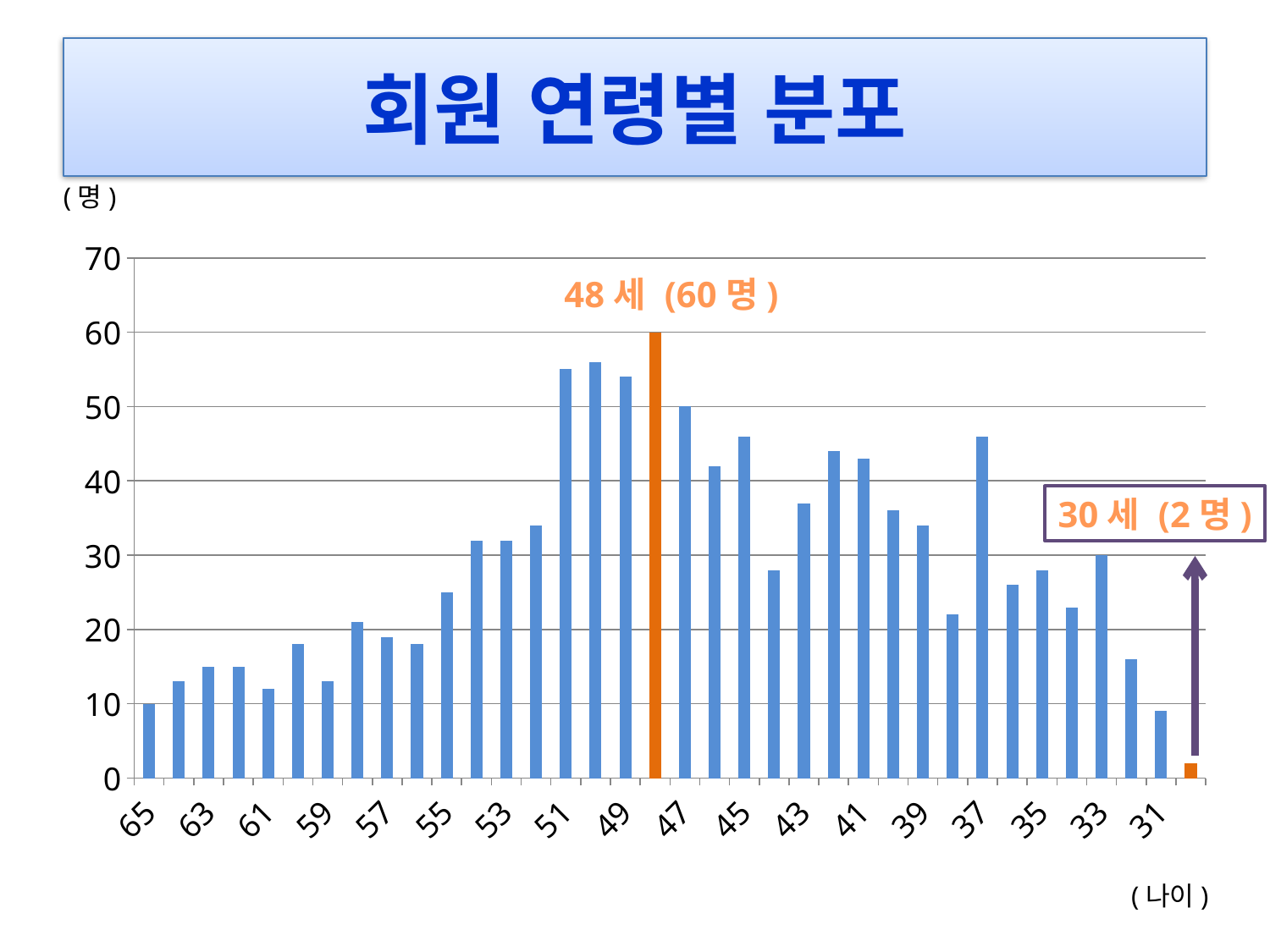
Which age has the lowest number of members? 30세 What is the difference between the number of members aged 48 and aged 30? 58명 What is the value for age 30 (30세) in the chart? 2명 Which age has the highest number of members? 48세 Which has more members, age 48 or age 30? 48세 Is the value for age 51 greater or less than 50? greater Moving from age 65 toward age 48 along the x axis, do the values generally rise or fall? rise Is the value for age 37 greater or less than 40? greater Is the value for age 65 greater or less than 20? less What kind of chart is shown on the slide? bar chart What is the value for age 48 (48세) in the chart? 60명 Which has more members, age 51 or age 65? 51세